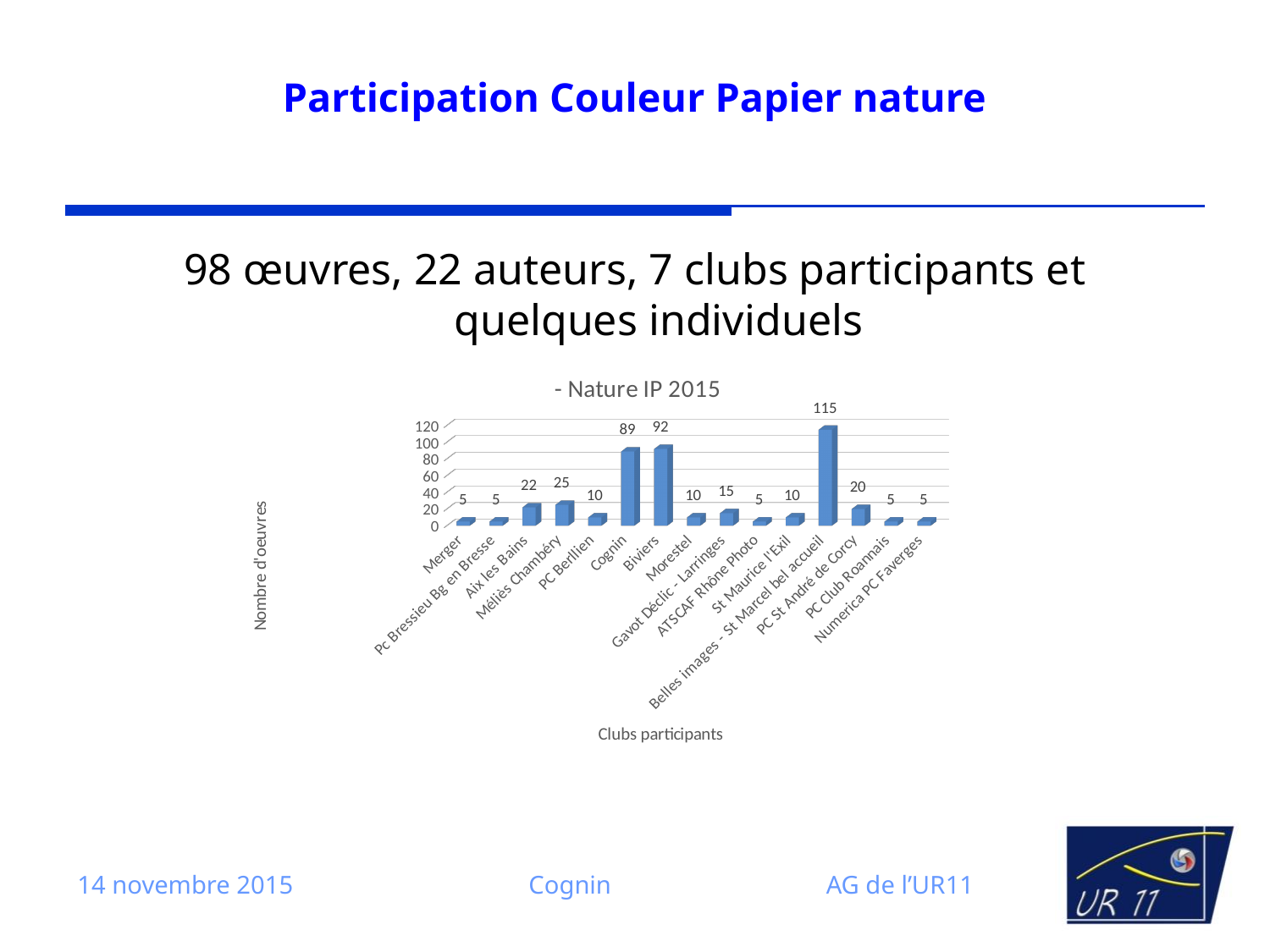
What is the value for Méliès Chambéry? 25 What is the value for PC St André de Corcy? 20 What is the value for Cognin? 89 Which club has the highest value in the chart? Belles images - St Marcel bel accueil What is the difference between the values for Biviers and Cognin? 3 What is the difference between the values for Belles images - St Marcel bel accueil and Biviers? 23 What type of chart is shown on the slide? bar chart How many clubs (categories) are plotted on the x axis of the chart? 15 What is the label of the vertical axis of the chart? Nombre d'oeuvres What is the value for Biviers? 92 What is the title of the chart? - Nature IP 2015 Which is larger, the value for Aix les Bains or the value for Gavot Déclic - Larringes? Aix les Bains